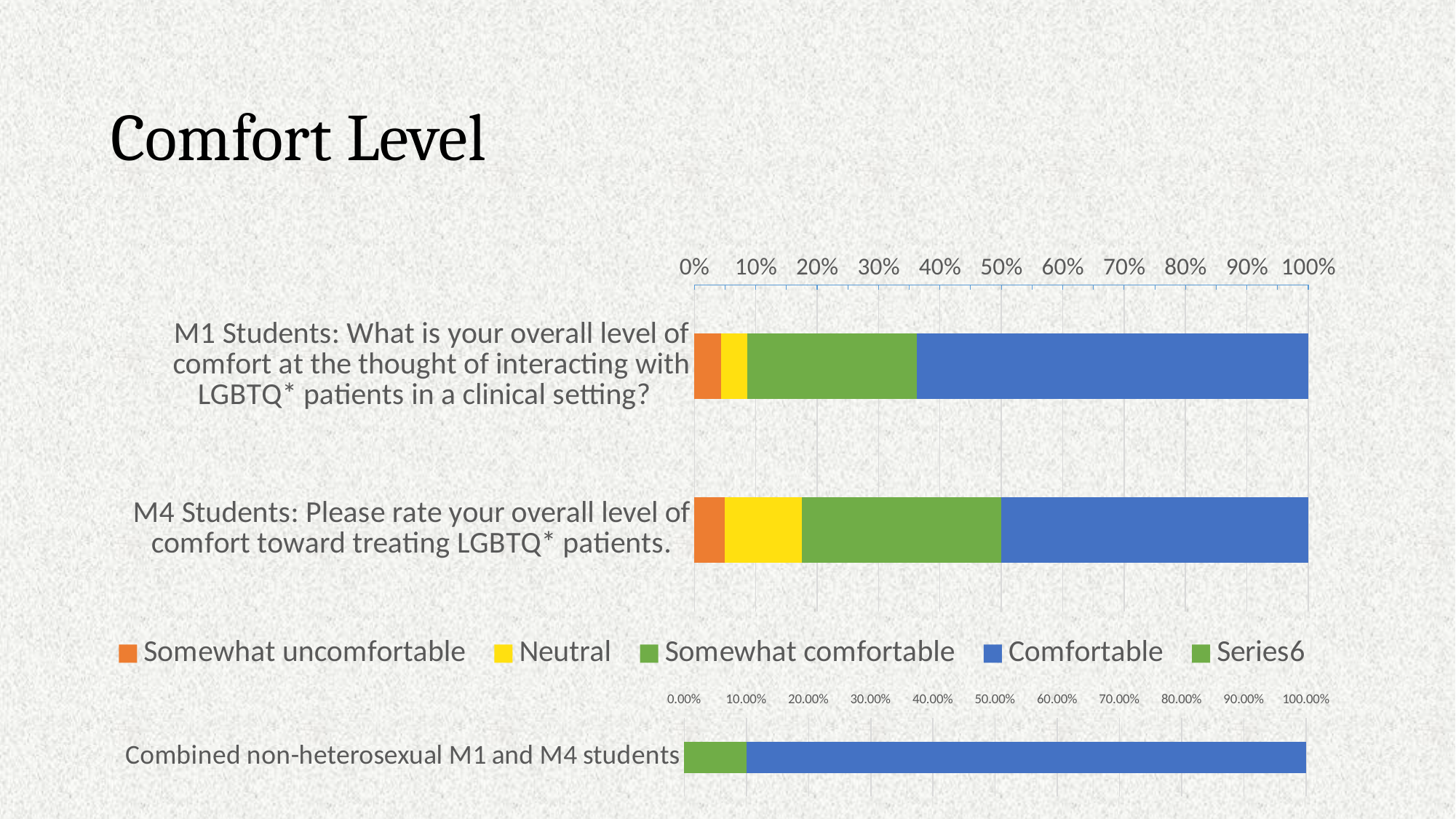
What kind of chart is the upper chart on the slide? stacked bar chart How many categories does the upper chart show? 2 What colour represents the Comfortable series in the upper chart's legend? blue In the upper chart, which group has the larger Comfortable segment, M1 Students or M4 Students? M1 Students In the upper chart, is the Neutral value for M4 Students greater or less than 10%? greater In the upper chart, is the Comfortable value for M1 Students greater or less than 60%? greater How many series does the legend of the upper chart list? 5 In the lower chart, is the blue segment for Combined non-heterosexual M1 and M4 students greater or less than 80.00%? greater In the upper chart, which group has the larger Neutral segment, M1 Students or M4 Students? M4 Students